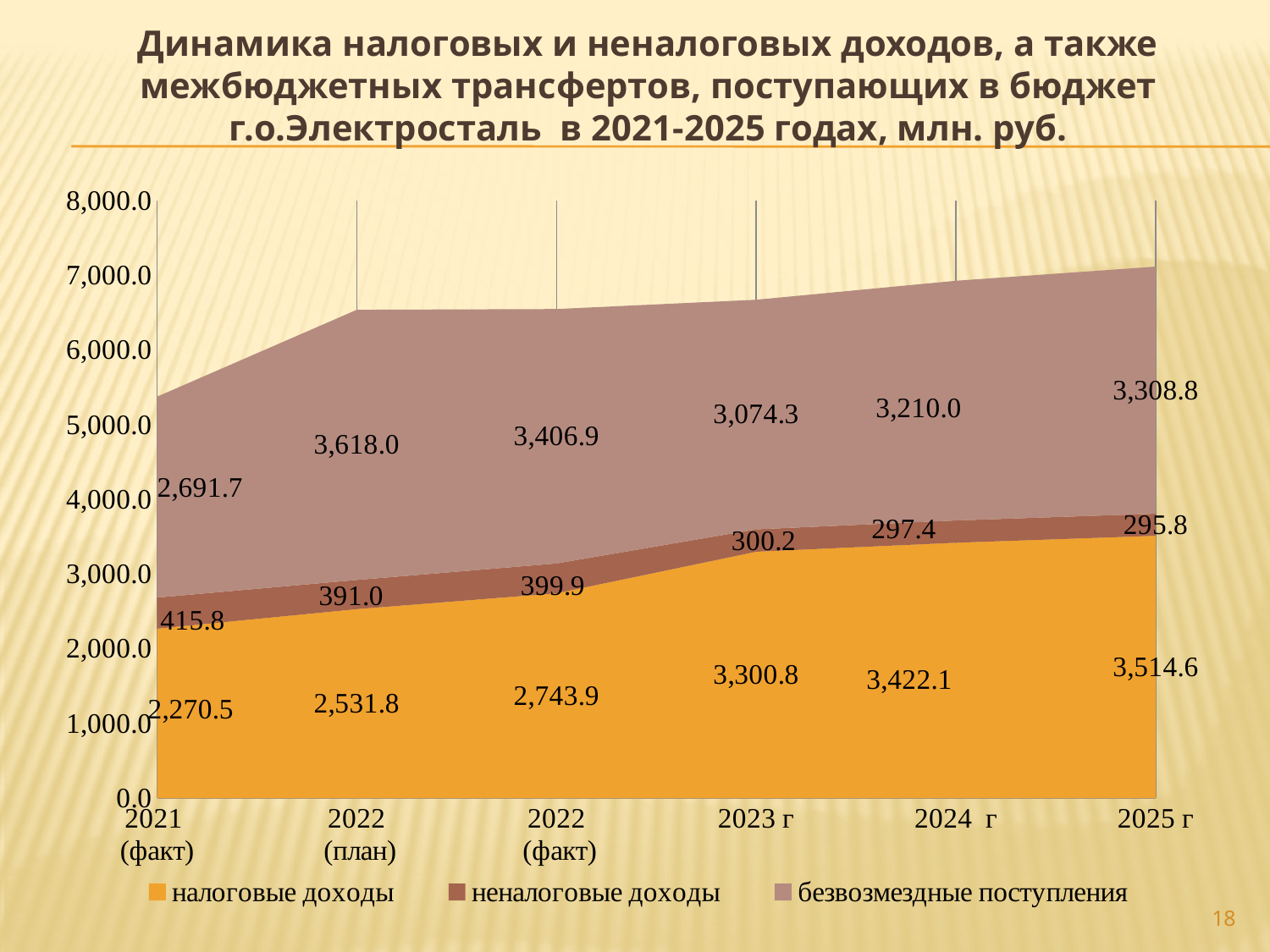
What is the value of безвозмездные поступления for 2022 (план)? 3,618.0 How many periods are shown on the x axis? 6 How many series does the legend list? 3 Do the values of налоговые доходы rise or fall from 2021 (факт) to 2025 г? Rise What is the total of all three series for 2025 г? 7,119.2 What kind of chart is shown on the slide? Stacked area chart What is the value of неналоговые доходы for 2021 (факт)? 415.8 Which is larger in 2023 г: налоговые доходы or безвозмездные поступления? налоговые доходы What is the value of налоговые доходы for 2025 г? 3,514.6 In which period is неналоговые доходы lowest? 2025 г In which period is безвозмездные поступления highest? 2022 (план) What is the difference between налоговые доходы in 2025 г and in 2021 (факт)? 1,244.1